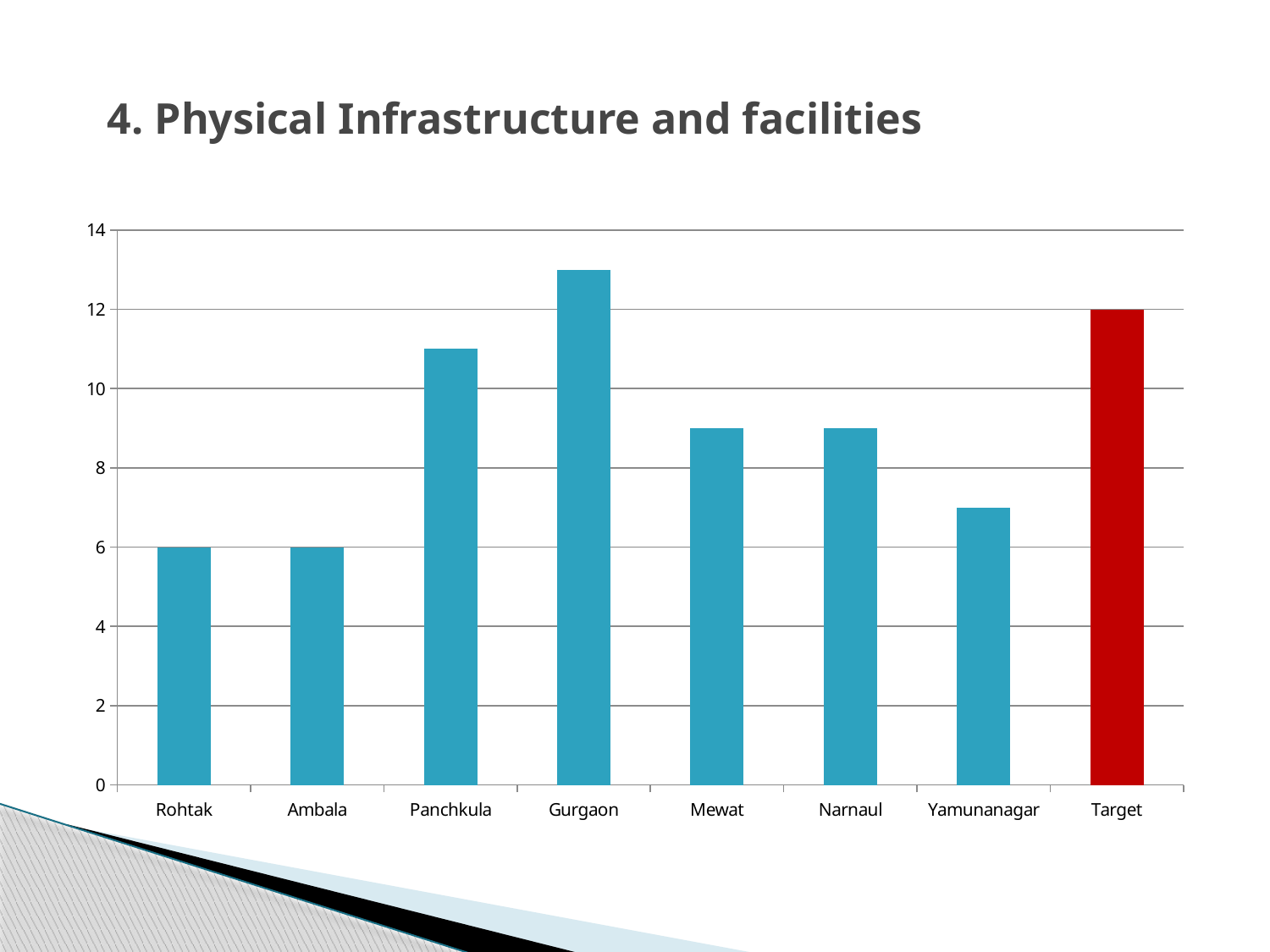
What is the difference between the Target value and the Rohtak value? 6 How many categories are shown on the x axis? 8 Is the value for Yamunanagar greater or less than 8? less Which is larger, the value for Panchkula or the value for Mewat? Panchkula What is the value for Target? 12 Which is larger, the value for Gurgaon or the value for Target? Gurgaon Is the value for Panchkula greater or less than 10? greater What is the value for Rohtak? 6 Is the value for Gurgaon greater or less than 12? greater What is the value for Ambala? 6 Which category has the highest value? Gurgaon What kind of chart is shown on the slide? bar chart